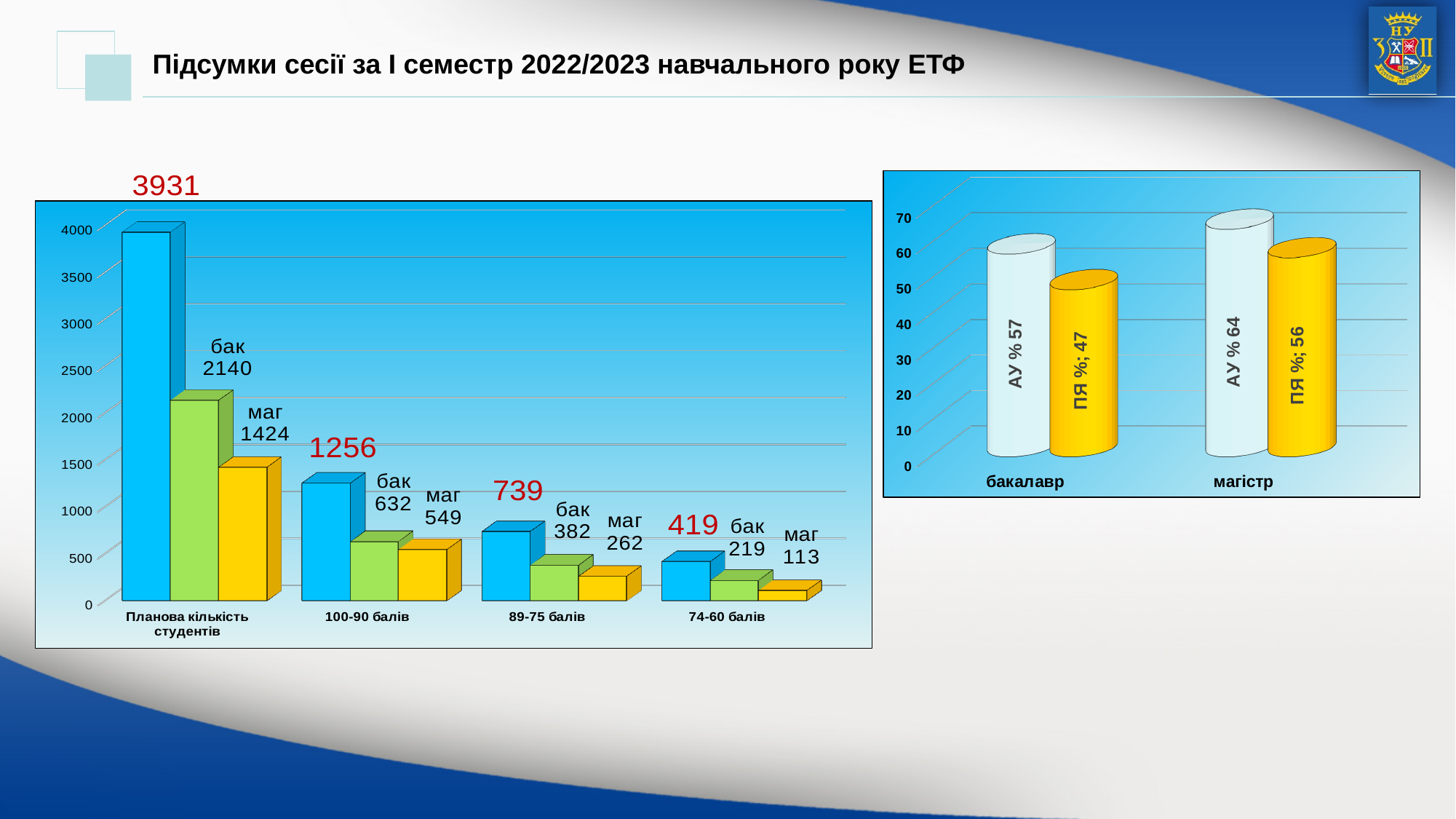
On the right chart, what is the 'ПЯ %' value for 'бакалавр'? 47 What type of chart is the left chart? bar chart On the right chart, what is the 'АУ %' value for 'магістр'? 64 On the left chart, do the total values rise or fall from 'Планова кількість студентів' to '74-60 балів'? fall On the left chart, what is the 'маг' value for '100-90 балів'? 549 On the left chart, what is the 'маг' value for '74-60 балів'? 113 On the left chart, what is the total value shown for 'Планова кількість студентів'? 3931 On the left chart, what is the difference between the 'бак' and 'маг' values for 'Планова кількість студентів'? 716 On the left chart, which category has the lowest total value? 74-60 балів On the left chart, how many categories are shown on the x axis? 4 On the left chart, what is the 'бак' value for '89-75 балів'? 382 On the right chart, which is larger: 'ПЯ %' for 'бакалавр' or 'ПЯ %' for 'магістр'? ПЯ % for магістр